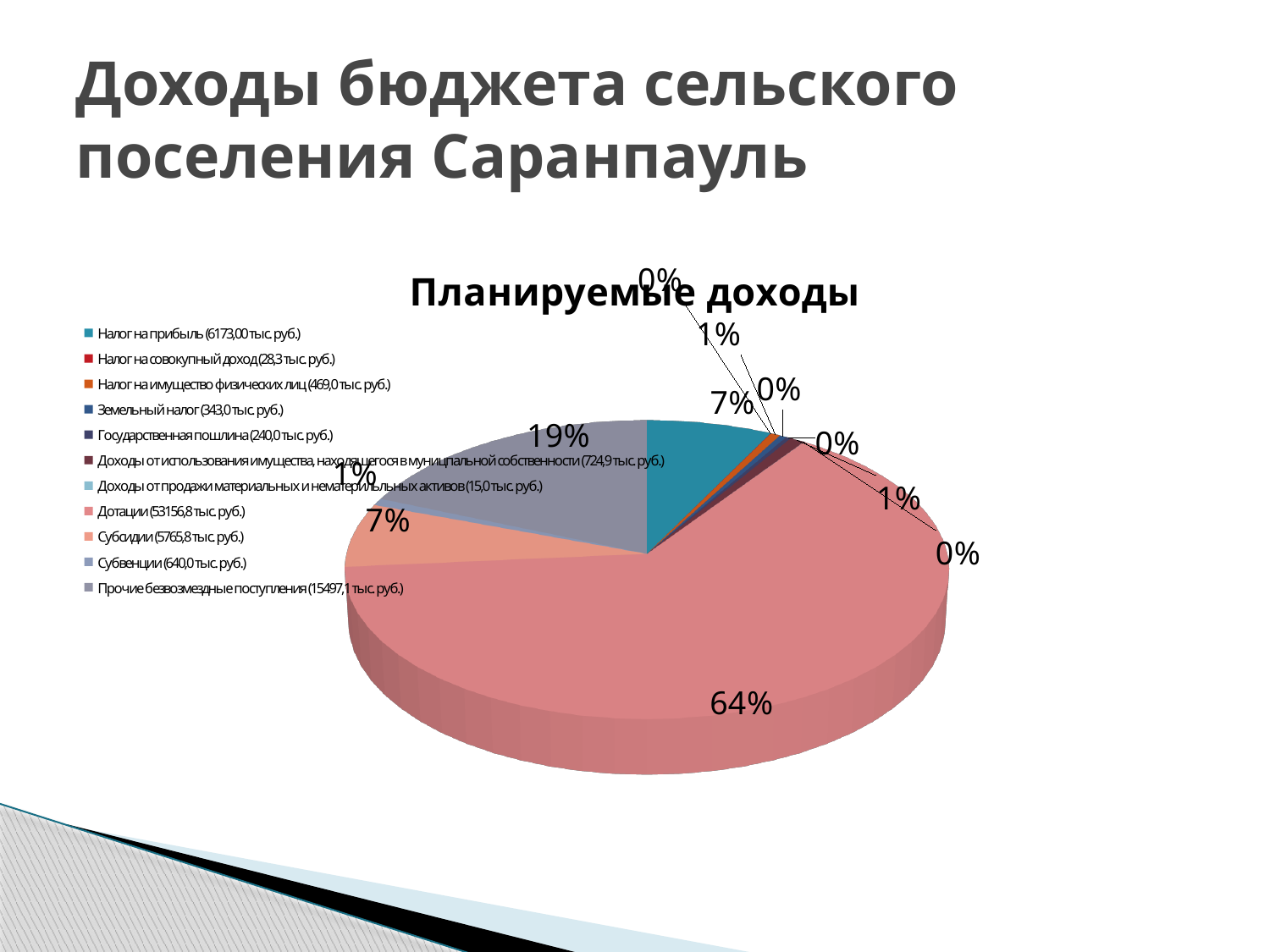
What amount is given in the legend for Налог на прибыль? 6173,00 тыс. руб. What kind of chart is shown on the slide? pie chart Which category has the largest slice of the pie? Дотации What share of the pie does Дотации account for? 64% What amount is given in the legend for Дотации? 53156,8 тыс. руб. According to the legend amounts, which is larger, Субсидии or Субвенции? Субсидии How many categories does the legend of the pie chart list? 11 What share of the pie does Прочие безвозмездные поступления account for? 19% Which is larger, the slice for Дотации or the slice for Прочие безвозмездные поступления? Дотации By how many percentage points does the Дотации share (64%) exceed the Прочие безвозмездные поступления share (19%)? 45 percentage points What is the title of the chart? Планируемые доходы What amount is given in the legend for Прочие безвозмездные поступления? 15497,1 тыс. руб.